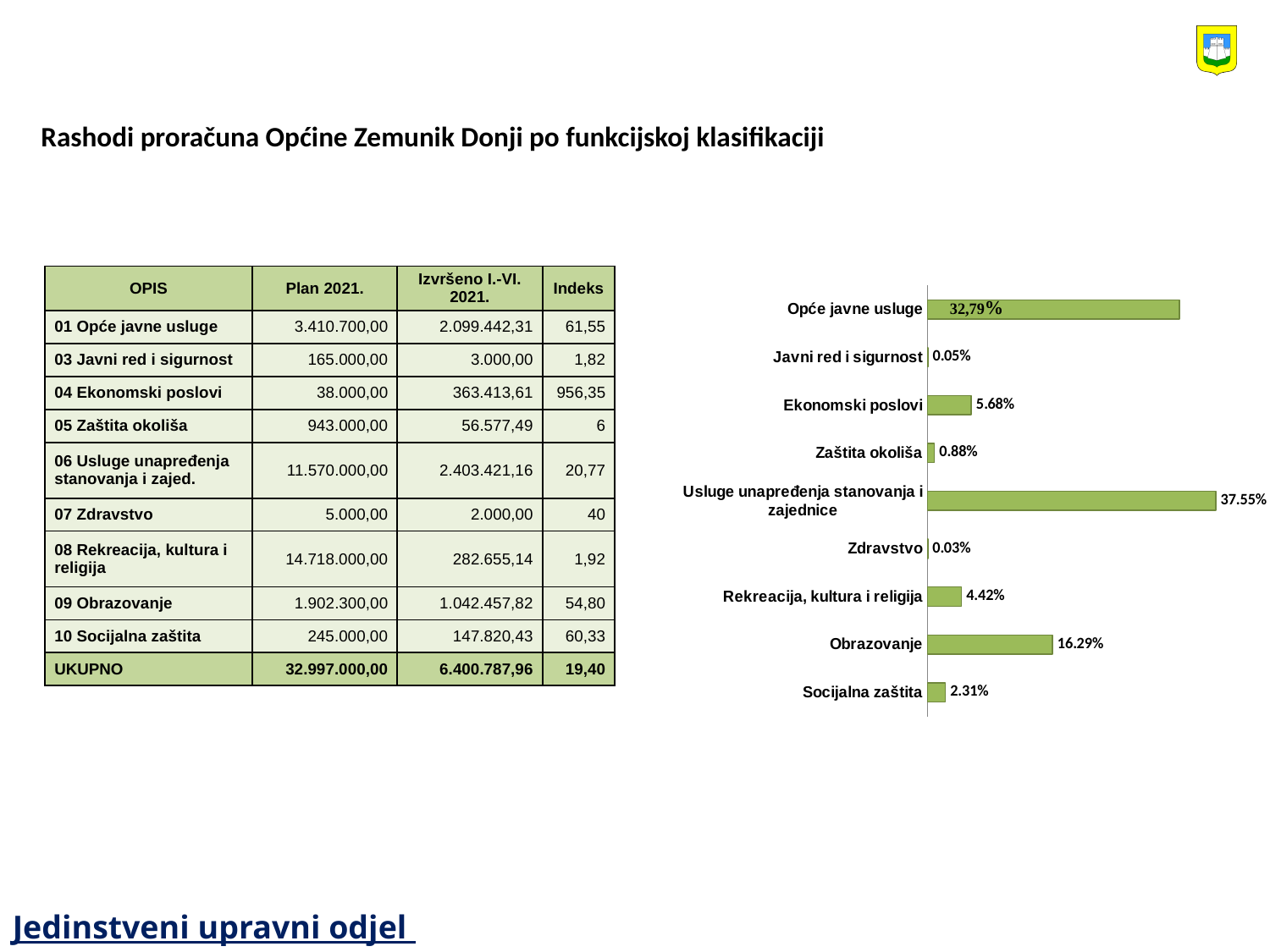
How many categories does the bar chart show? 9 What is the difference between the values for Obrazovanje and Socijalna zaštita in the bar chart? 13.98% What is the value shown for Javni red i sigurnost in the bar chart? 0.05% In the bar chart, which is larger: Rekreacija, kultura i religija or Ekonomski poslovi? Ekonomski poslovi What is the value shown for Obrazovanje in the bar chart? 16.29% Which category has the highest value in the bar chart? Usluge unapređenja stanovanja i zajednice What kind of chart is shown on the right side of the slide? bar chart What is the value shown for Ekonomski poslovi in the bar chart? 5.68% What is the value shown for Socijalna zaštita in the bar chart? 2.31% What is the value shown for Usluge unapređenja stanovanja i zajednice in the bar chart? 37.55% What is the value shown for Zaštita okoliša in the bar chart? 0.88% Which category has the lowest value in the bar chart? Zdravstvo